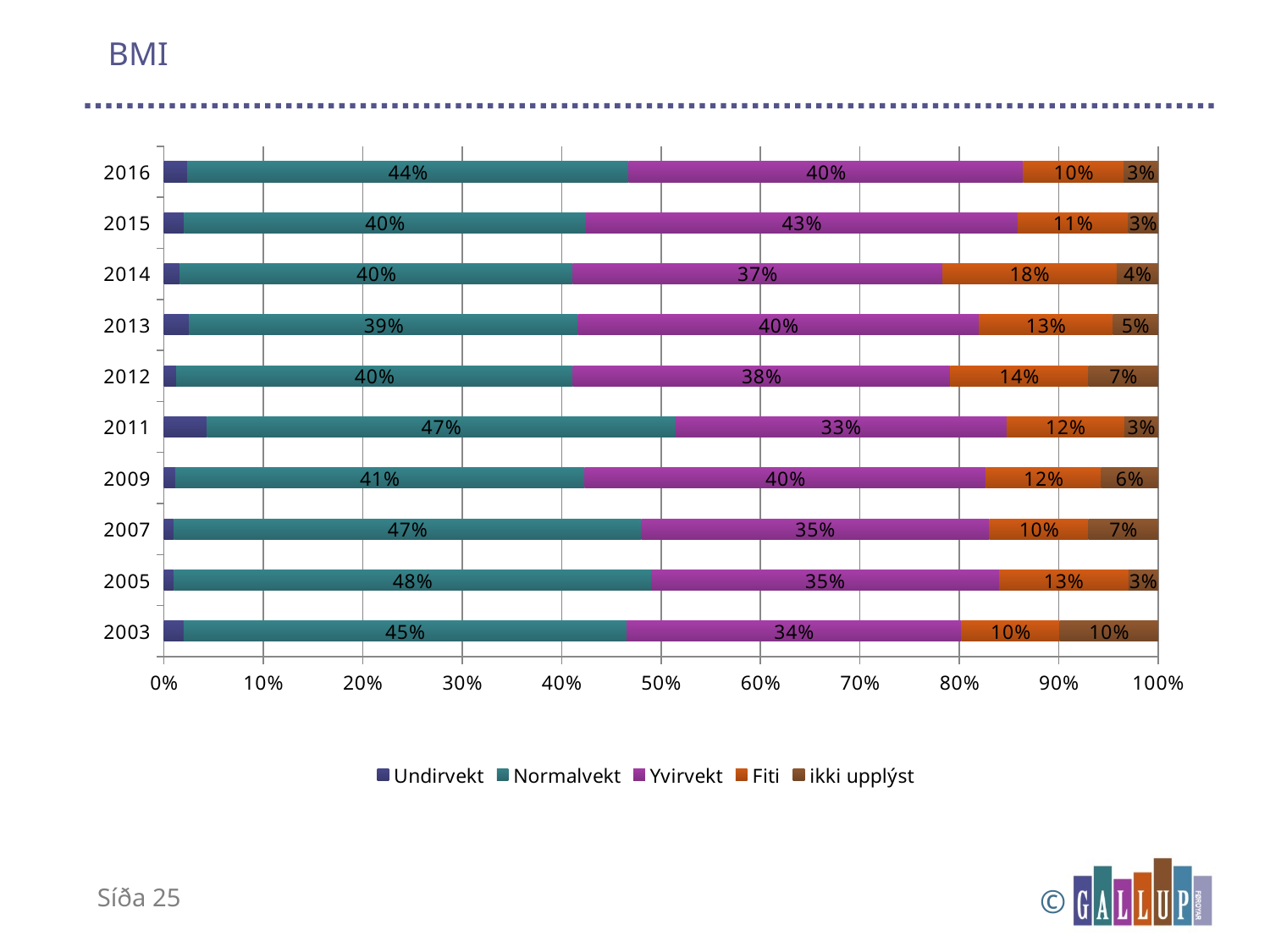
What kind of chart is shown on the slide? Stacked bar chart How many years are shown on the chart? 10 What is the title of the slide? BMI Which year has the highest Normalvekt value? 2005 What is the Yvirvekt value for 2011? 33% What is the Normalvekt value for 2016? 44% What is the ikki upplýst value for 2003? 10% Which is larger, the Yvirvekt value for 2015 or the Yvirvekt value for 2014? 2015 What is the Fiti value for 2014? 18% What is the difference between the Fiti values for 2014 and 2016? 8% Which year has the lowest Yvirvekt value? 2011 How many series does the legend list? 5